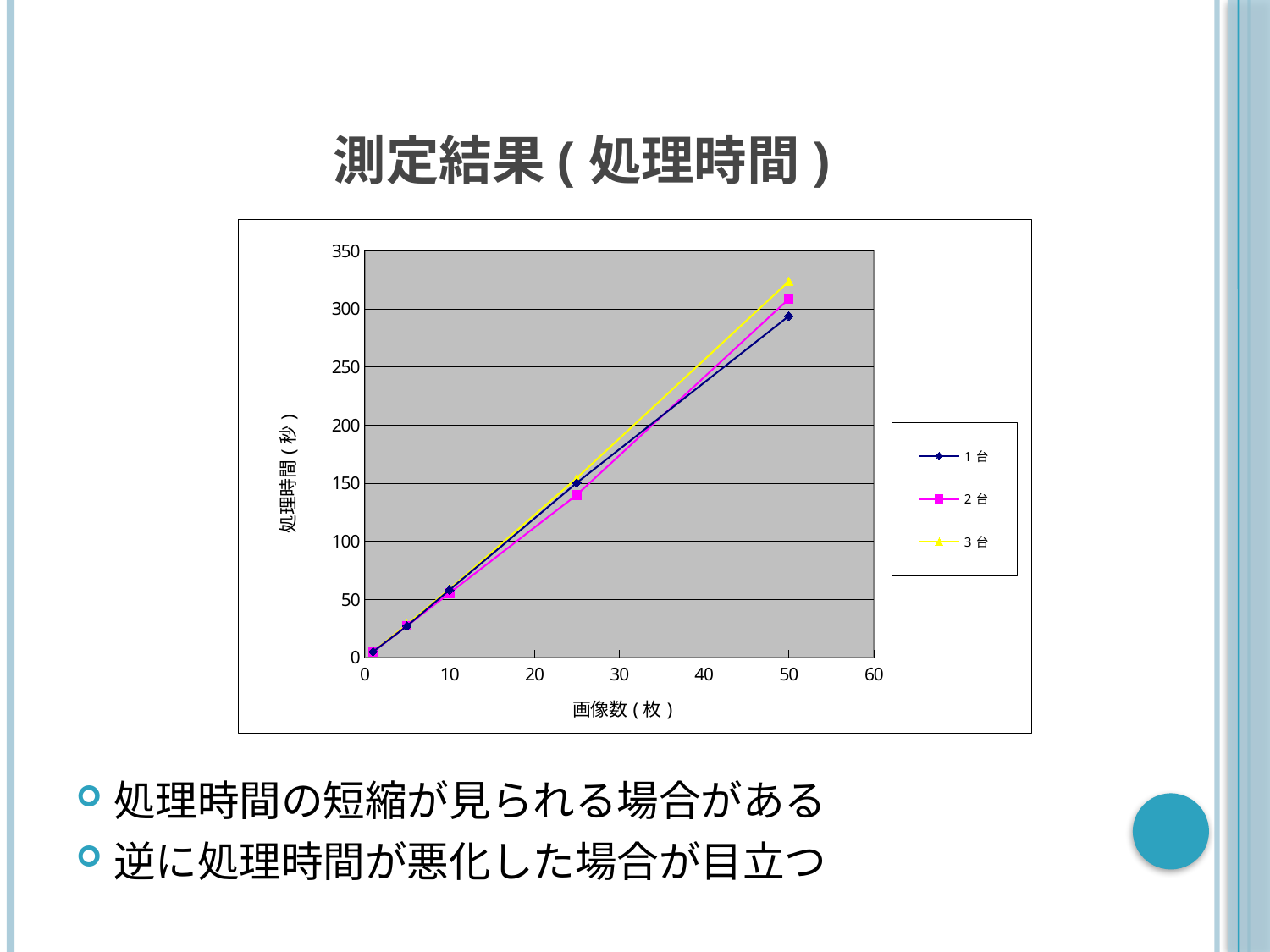
What are the series names listed in the legend? 1台, 2台, 3台 At 50 images, which series has the highest processing time? 3台 How many series does the legend list? 3 At 25 images, which is larger: the value for 1台 or the value for 2台? 1台 At 50 images, which series has the lowest processing time? 1台 Is the value for 2台 at 25 images greater or less than 150? less What is the label of the y axis? 処理時間(秒) What kind of chart is shown on the slide? line chart Do the processing time values rise or fall as the number of images increases? rise Is the value for 3台 at 50 images greater or less than 300? greater How many data points are plotted for the 1台 series? 5 Is the value for 1台 at 50 images greater or less than 300? less